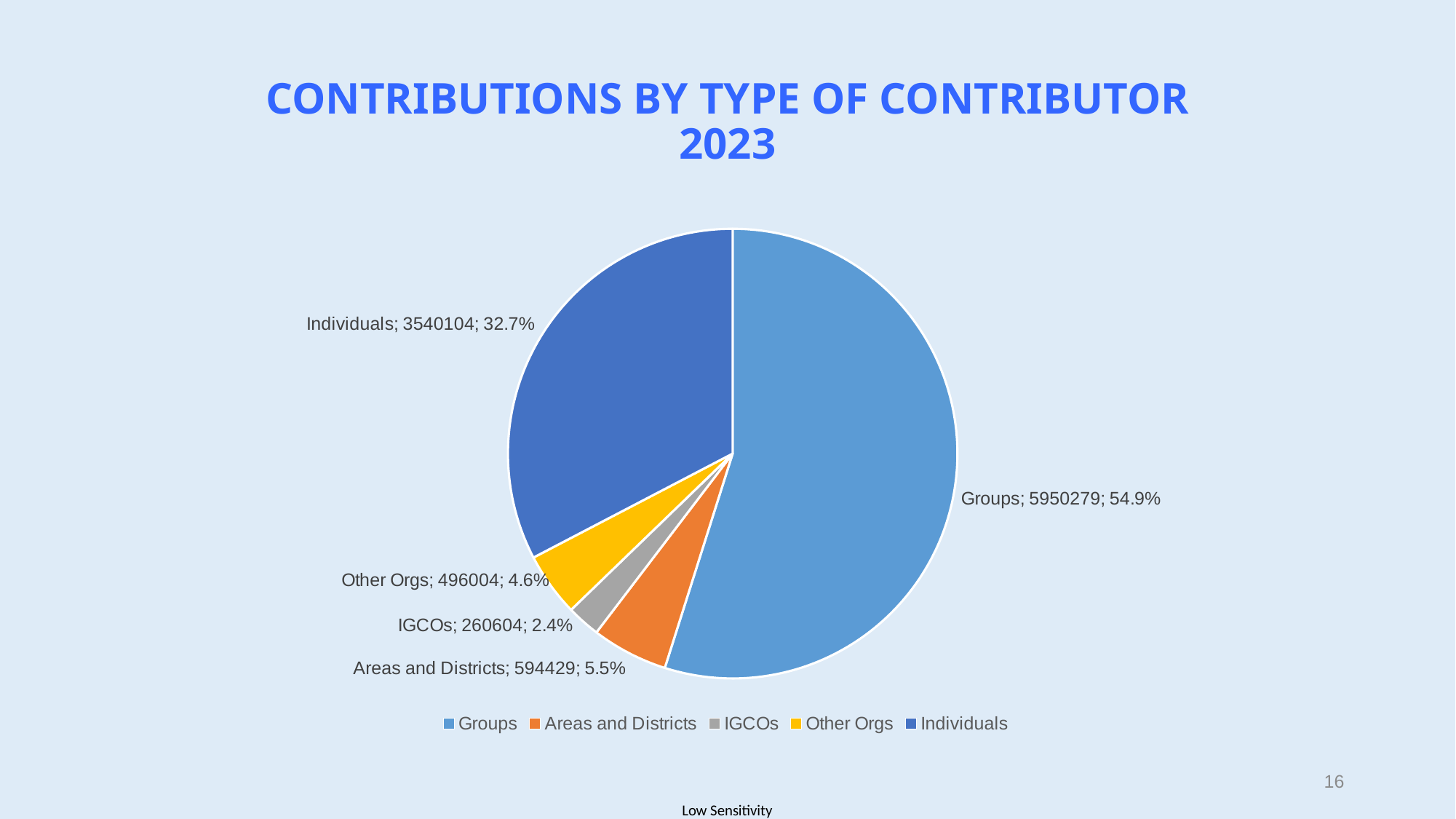
What is the contribution value for Groups? 5950279 What is the contribution value for Individuals? 3540104 Which type of contributor has the smallest contribution? IGCOs What share of the pie does Other Orgs represent? 4.6% Which is larger, the contribution from Areas and Districts or from Other Orgs? Areas and Districts What kind of chart is shown on the slide? pie chart What is the contribution value for IGCOs? 260604 What share of the pie does Areas and Districts represent? 5.5% Which type of contributor has the largest contribution? Groups What is the difference between the contributions of Groups and Individuals? 2410175 How many types of contributor are shown in the pie chart? 5 What is the title of the chart? CONTRIBUTIONS BY TYPE OF CONTRIBUTOR 2023